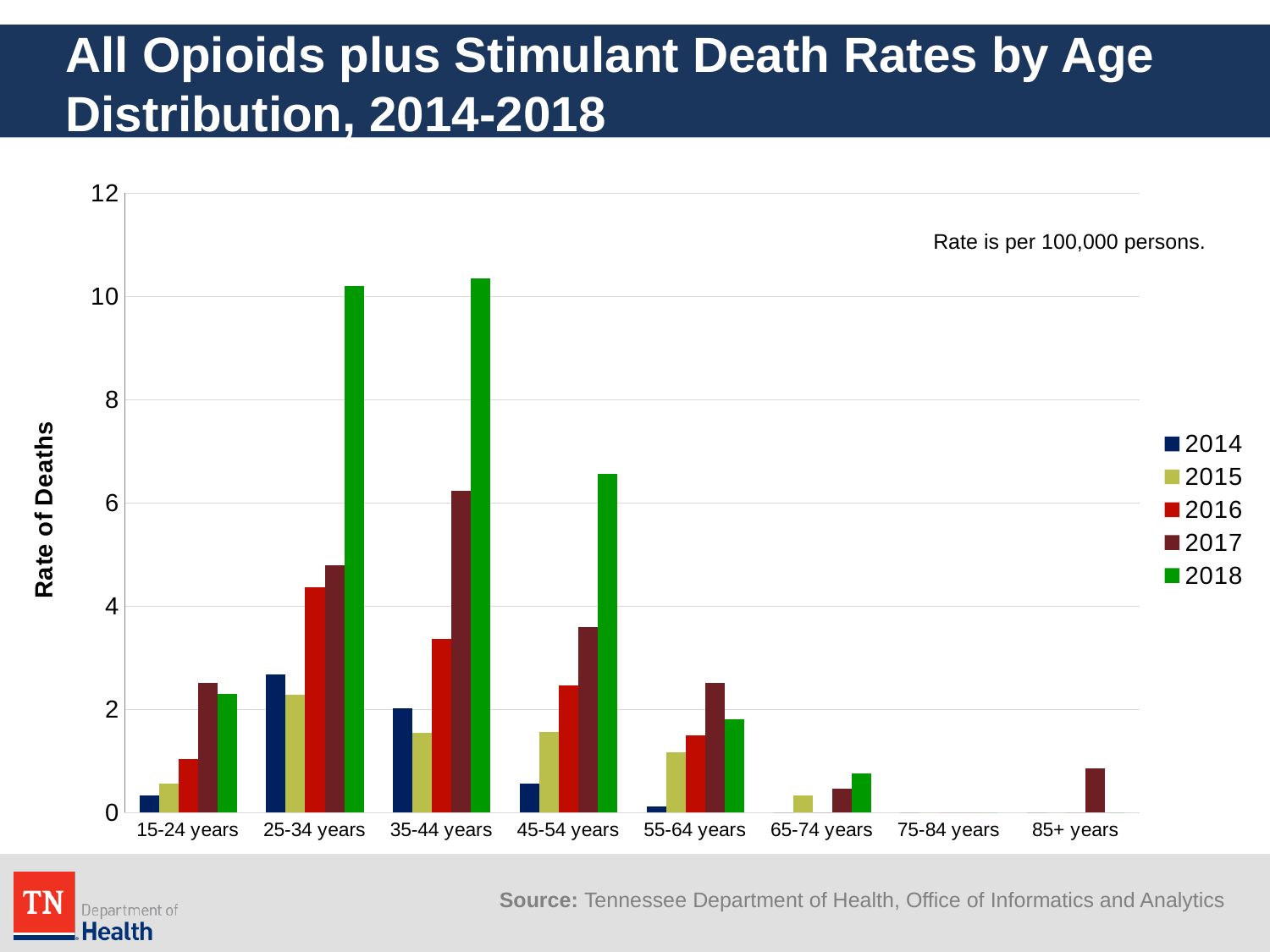
What colour represents 2018 in the legend? Green According to the note on the chart, what is the rate per? 100,000 persons Is the 2016 value for 35-44 years greater or less than 4? less For 25-34 years, which year has the larger death rate, 2014 or 2015? 2014 Which age group has the highest 2017 death rate? 35-44 years How many age groups are shown on the x axis? 8 For 15-24 years, does the death rate rise or fall from 2014 to 2017? rise For 55-64 years, which year has the larger death rate, 2017 or 2018? 2017 Is the 2018 value for 25-34 years greater or less than 8? greater How many series does the legend list? 5 Is the 2018 value for 45-54 years greater or less than 6? greater What kind of chart is shown on the slide? Bar chart